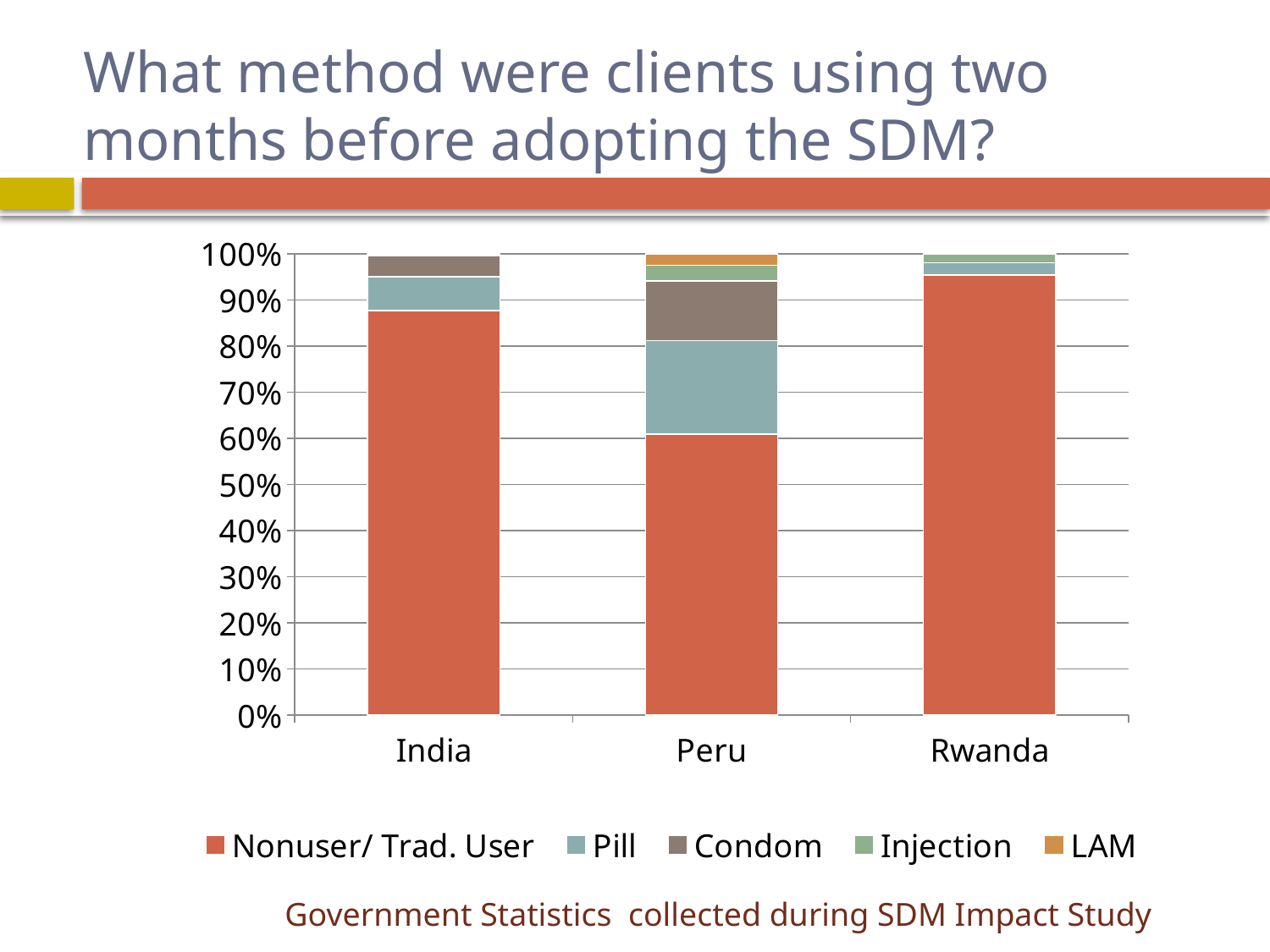
What kind of chart is shown on the slide? Stacked bar chart Which country is the only one with a LAM segment in its bar? Peru Is the Nonuser/ Trad. User share for India greater or less than 80%? greater How many countries are shown on the x axis of the chart? 3 Is the Nonuser/ Trad. User share for Rwanda greater or less than 90%? greater What is the total height of each stacked bar on the chart? 100% Which country has the highest Nonuser/ Trad. User share? Rwanda What is the title of the slide containing the chart? What method were clients using two months before adopting the SDM? Which country has the larger Pill share, India or Peru? Peru How many series does the chart legend list? 5 Is the Nonuser/ Trad. User share for Peru greater or less than 70%? less Which country has the lowest Nonuser/ Trad. User share? Peru